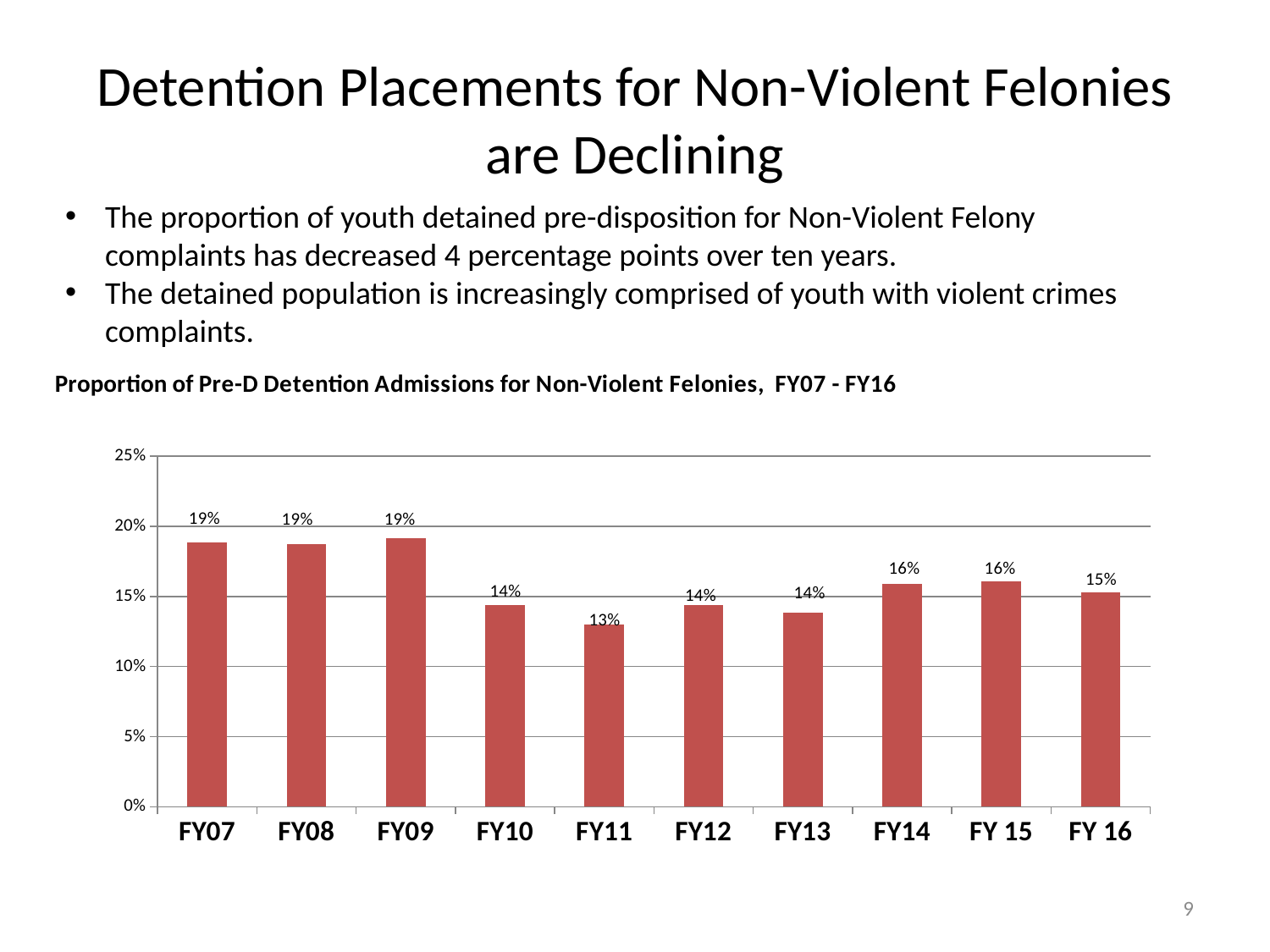
Do the values generally rise or fall from FY07 to FY 16? fall What is the difference between the values for FY07 and FY 16? 4 percentage points How many fiscal years are shown on the x axis? 10 Is the value for FY08 greater or less than 15%? greater What is the title of the chart? Proportion of Pre-D Detention Admissions for Non-Violent Felonies, FY07 - FY16 What is the value for FY11? 13% What is the value for FY 16? 15% Which fiscal year has the lowest value? FY11 What kind of chart is shown on the slide? bar chart What is the value for FY14? 16% Which is larger, the value for FY09 or the value for FY10? FY09 What is the value for FY07? 19%